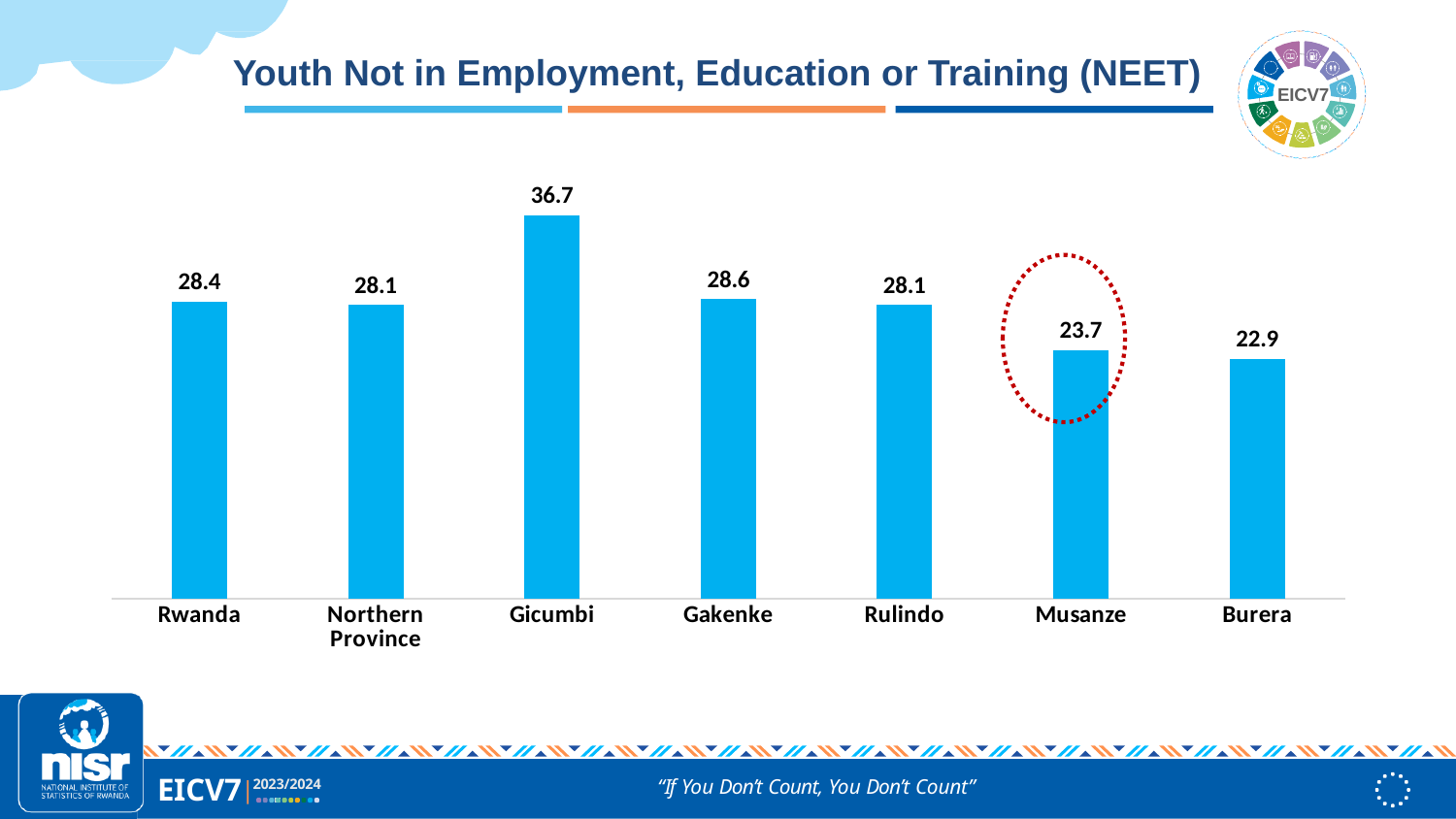
What is the NEET value for Musanze? 23.7 Which category has the lowest NEET value? Burera What is the NEET value for Burera? 22.9 What kind of chart is shown on the slide? Bar chart What is the NEET value for Gicumbi? 36.7 Which category's bar is highlighted with a red dotted circle? Musanze How many categories are shown on the chart? 7 What is the difference between the NEET values for Gakenke and Musanze? 4.9 What is the NEET value for Rwanda? 28.4 What is the difference between the NEET values for Gicumbi and Burera? 13.8 Which has a higher NEET value, Gakenke or Rulindo? Gakenke Which category has the highest NEET value? Gicumbi